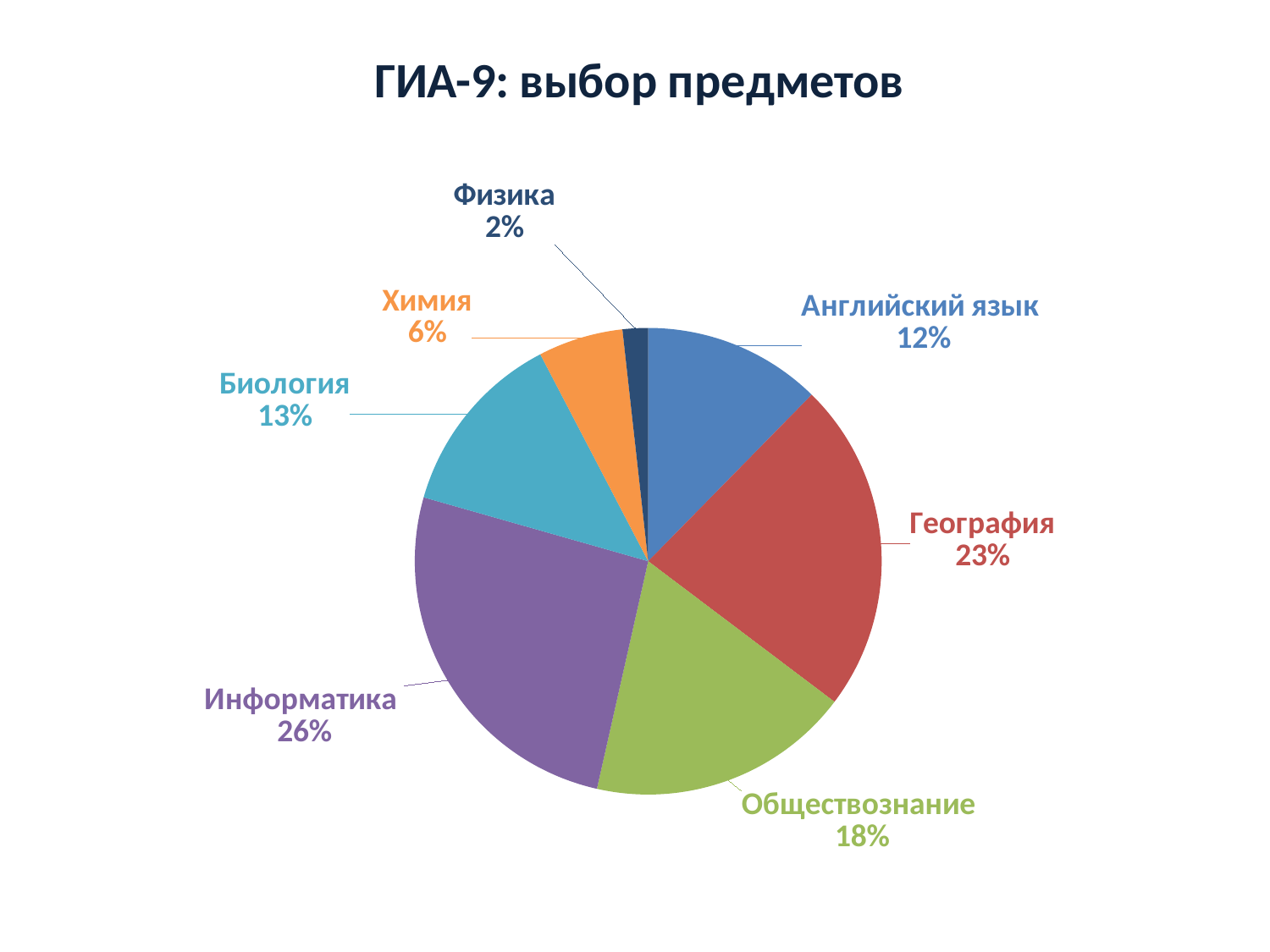
What colour is the slice for Химия? orange Which has a larger share, География or Биология? География What kind of chart is shown on the slide? pie chart What is the title of the chart? ГИА-9: выбор предметов What is the difference between the shares of Информатика and Обществознание? 8% Which subject has the smallest share of the pie? Физика Which subject has the largest share of the pie? Информатика What share of the pie does Физика have? 2% What share of the pie does География have? 23% How many subjects (slices) are shown in the pie chart? 7 What share of the pie does Информатика have? 26% What share of the pie does Английский язык have? 12%